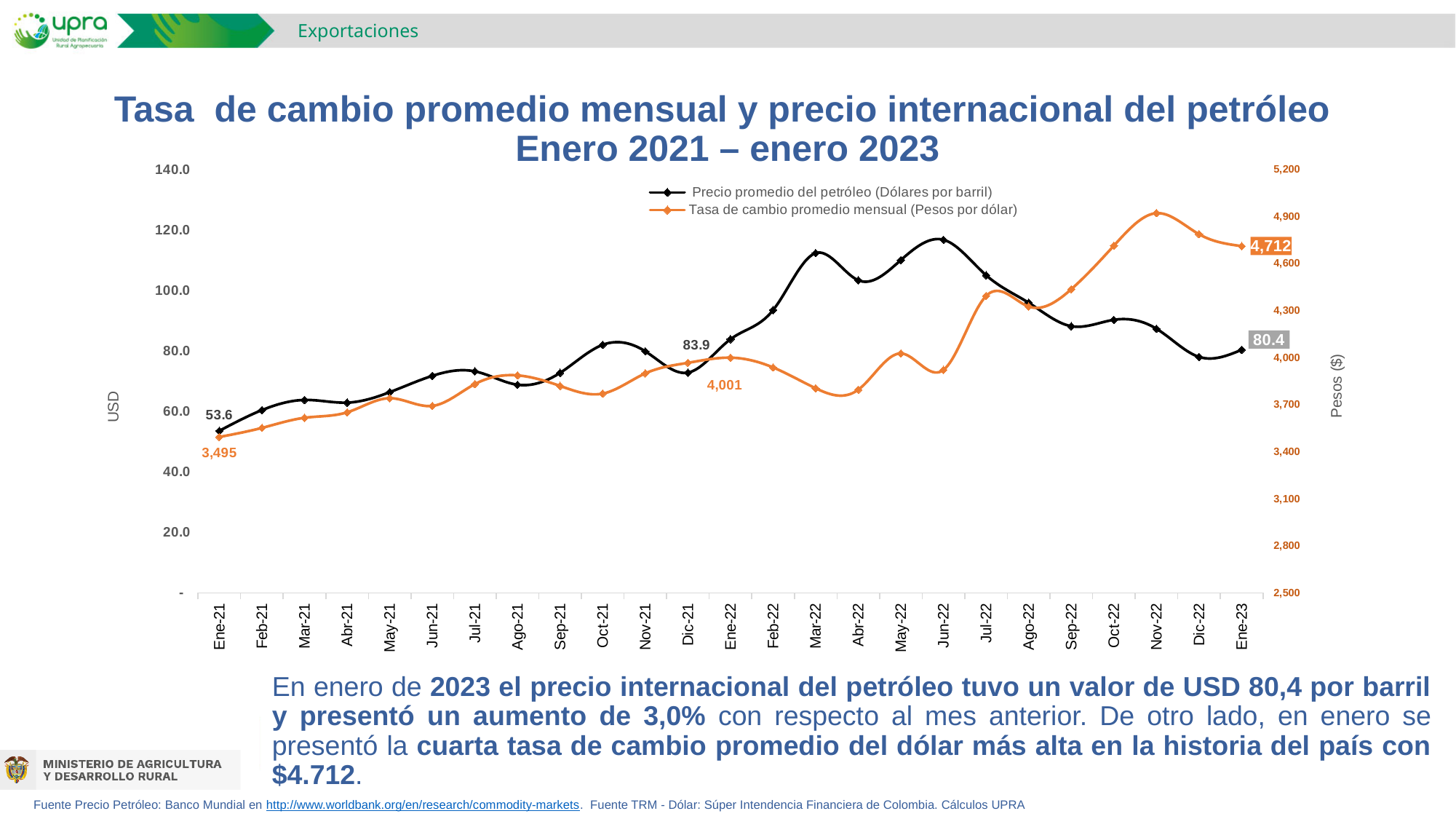
In which month was the Tasa de cambio promedio mensual at its highest? Nov-22 What was the Tasa de cambio promedio mensual (Pesos por dólar) in Ene-21? 3,495 What is the difference between the oil price in Ene-23 and in Ene-21? 26.8 What was the average oil price (Dólares por barril) in Ene-23? 80.4 What was the average oil price (Dólares por barril) in Ene-21? 53.6 How many series does the legend list? 2 Is the oil price for Mar-22 greater or less than 100? greater By how much did the Tasa de cambio promedio mensual increase from Ene-21 to Ene-23? 1,217 In which month did the Precio promedio del petróleo reach its highest value? Jun-22 What was the Tasa de cambio promedio mensual (Pesos por dólar) in Ene-23? 4,712 What kind of chart is shown on the slide? Line chart